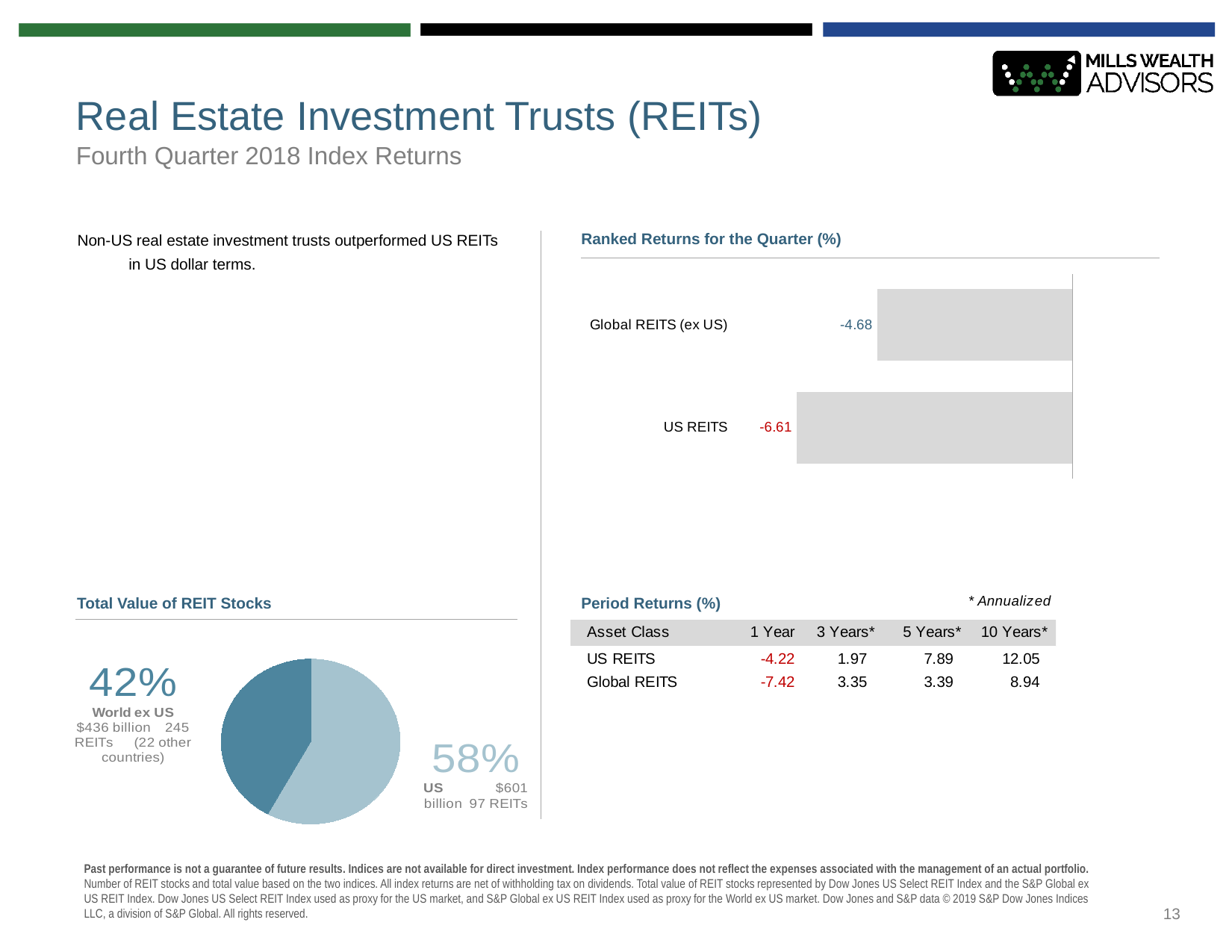
In the Total Value of REIT Stocks chart, what share of the pie is World ex US? 42% What kind of chart is the Ranked Returns for the Quarter (%) chart? Bar chart In the Ranked Returns for the Quarter (%) chart, which category has the highest value? Global REITS (ex US) In the Total Value of REIT Stocks chart, what share of the pie is US? 58% In the Ranked Returns for the Quarter (%) chart, what is the value for Global REITS (ex US)? -4.68 In the Ranked Returns for the Quarter (%) chart, which is larger, the value for Global REITS (ex US) or the value for US REITS? Global REITS (ex US) In the Ranked Returns for the Quarter (%) chart, what is the difference between the Global REITS (ex US) value and the US REITS value? 1.93 In the Ranked Returns for the Quarter (%) chart, which category has the lowest value? US REITS How many categories are shown in the Ranked Returns for the Quarter (%) chart? 2 What kind of chart is the Total Value of REIT Stocks chart? Pie chart In the Total Value of REIT Stocks chart, which slice is larger, US or World ex US? US In the Ranked Returns for the Quarter (%) chart, what is the value for US REITS? -6.61